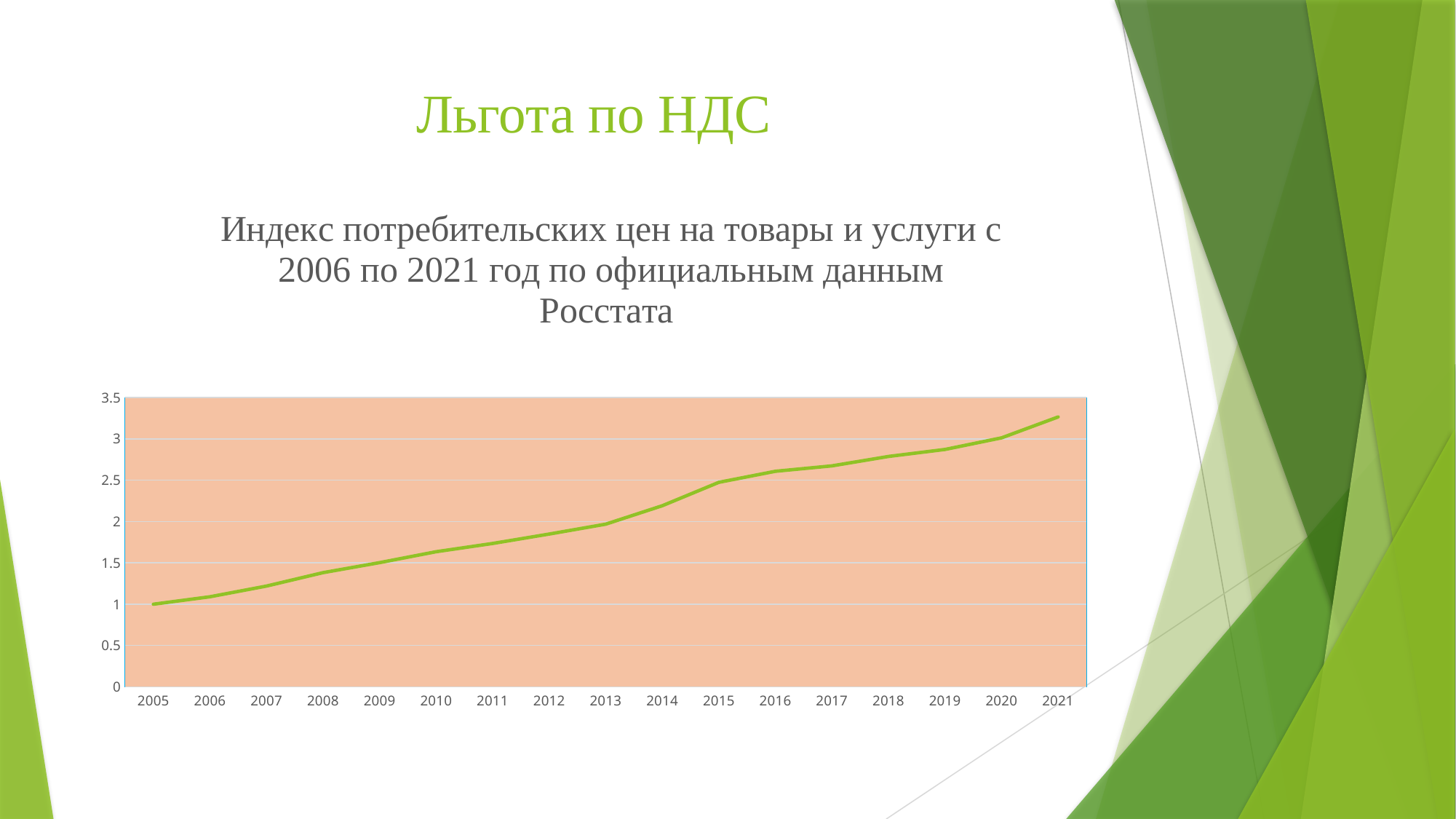
What kind of chart is shown on the slide? line chart Is the value for 2008 greater or less than 1.5? less Is the value for 2018 greater or less than 3? less What is the value for 2005 in the chart? 1 Which year has the lowest value in the chart? 2005 Is the value for 2021 greater or less than 3? greater Do the values in the chart rise or fall from 2005 to 2021? rise How many years are plotted along the x axis of the chart? 17 Which year has the highest value in the chart? 2021 Which year has the larger value, 2010 or 2016? 2016 What is the title of the chart on the slide? Индекс потребительских цен на товары и услуги с 2006 по 2021 год по официальным данным Росстата